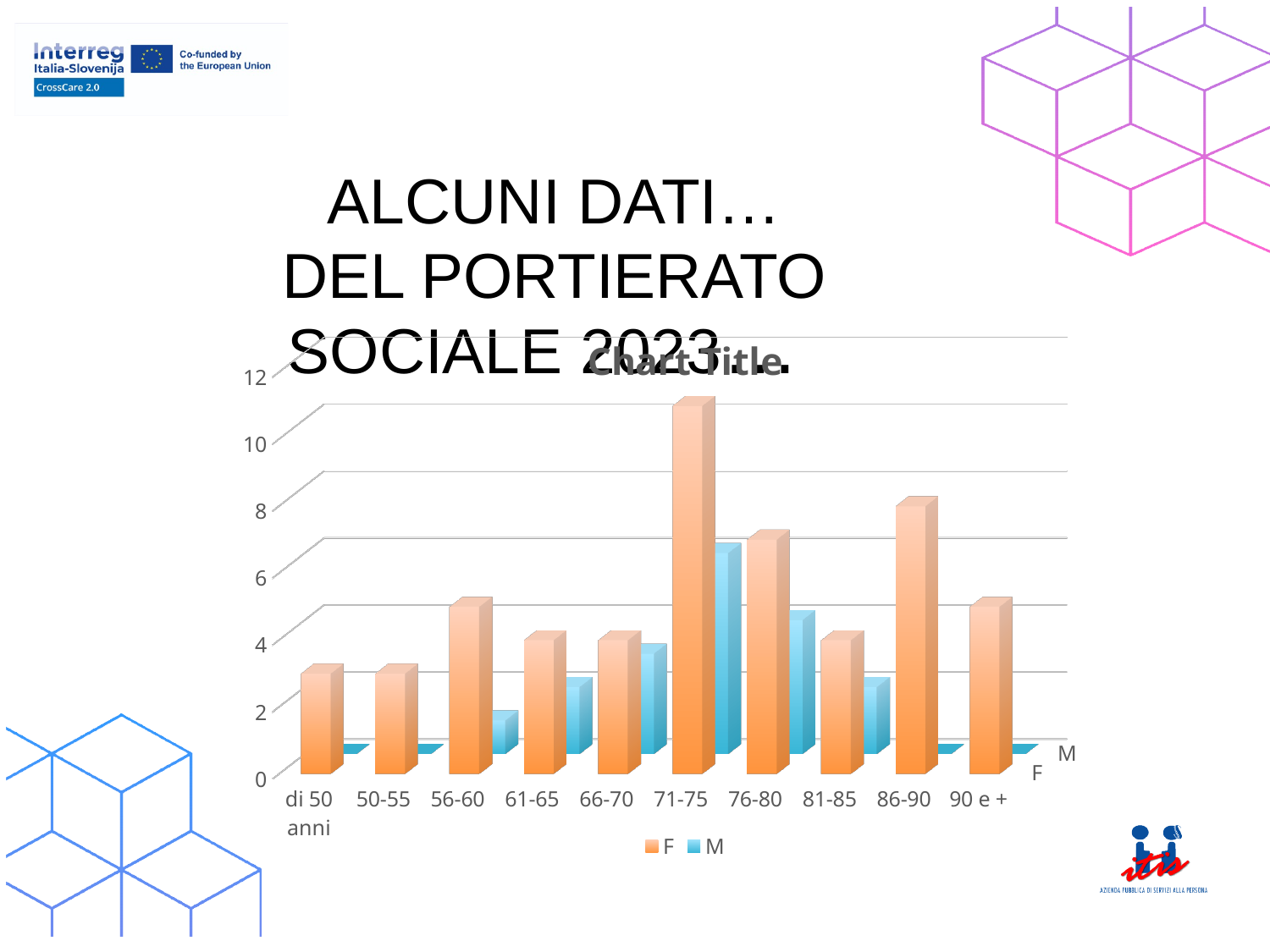
Is the M value for 56-60 greater or less than 4? less Which age category has the highest value for the M series? 71-75 Is the F value for 86-90 greater or less than 6? greater How many age categories are shown on the x axis? 10 Is the F value for 71-75 greater or less than 10? greater Which colour represents the M series in the legend? blue Which has the larger F value, 86-90 or 81-85? 86-90 How many series does the legend list? 2 Which age category has the highest value for the F series? 71-75 What kind of chart is shown on the slide? bar chart For the 71-75 category, which series has the larger value, F or M? F